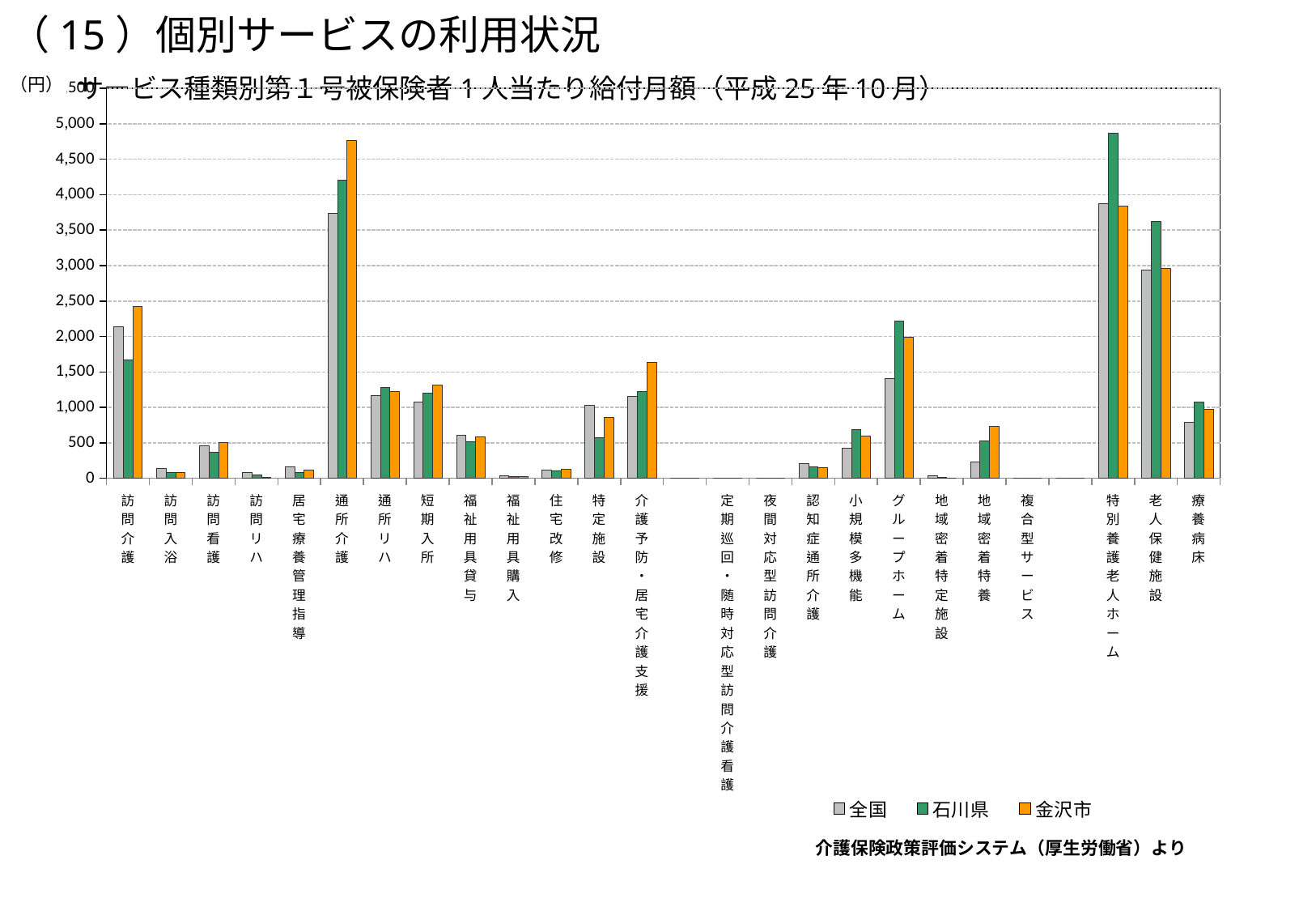
Is the value for 金沢市 in 特定施設 greater or less than 1,000? less Is the value for 全国 in 訪問介護 greater or less than 2,000? greater How many service categories are shown on the x axis? 24 Which category has the highest value for 石川県? 特別養護老人ホーム Which category has the highest value for 金沢市? 通所介護 Is the value for 石川県 in 特別養護老人ホーム greater or less than 4,500? greater What kind of chart is shown on the slide? bar chart For 特定施設, which is larger: 全国 or 石川県? 全国 Which colour represents 金沢市 in the legend? orange How many series does the legend list? 3 For 訪問介護, which is larger: 石川県 or 金沢市? 金沢市